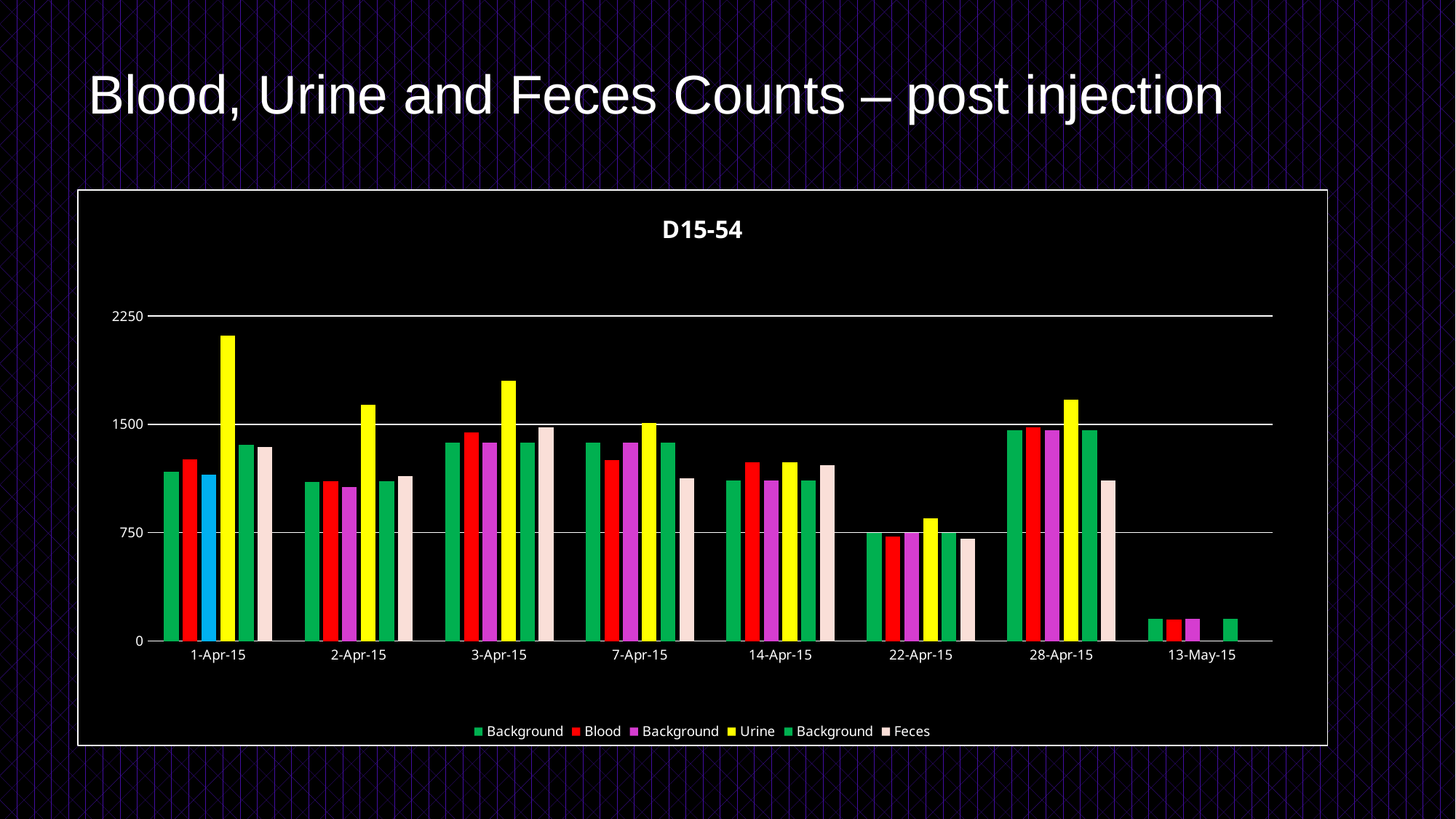
What colour are the Urine bars in the chart? yellow On which date is the Urine value highest? 1-Apr-15 How many series does the chart's legend list? 6 Is the Urine value for 1-Apr-15 greater or less than 1500? greater What kind of chart is shown on the slide? bar chart What is the title of the chart? D15-54 Is the Urine value for 2-Apr-15 greater or less than 1500? greater On which date is the Blood value lowest? 13-May-15 How many dates are shown on the x axis of the chart? 8 Is the Blood value for 13-May-15 greater or less than 750? less Which is larger: the Urine value for 1-Apr-15 or the Urine value for 3-Apr-15? 1-Apr-15